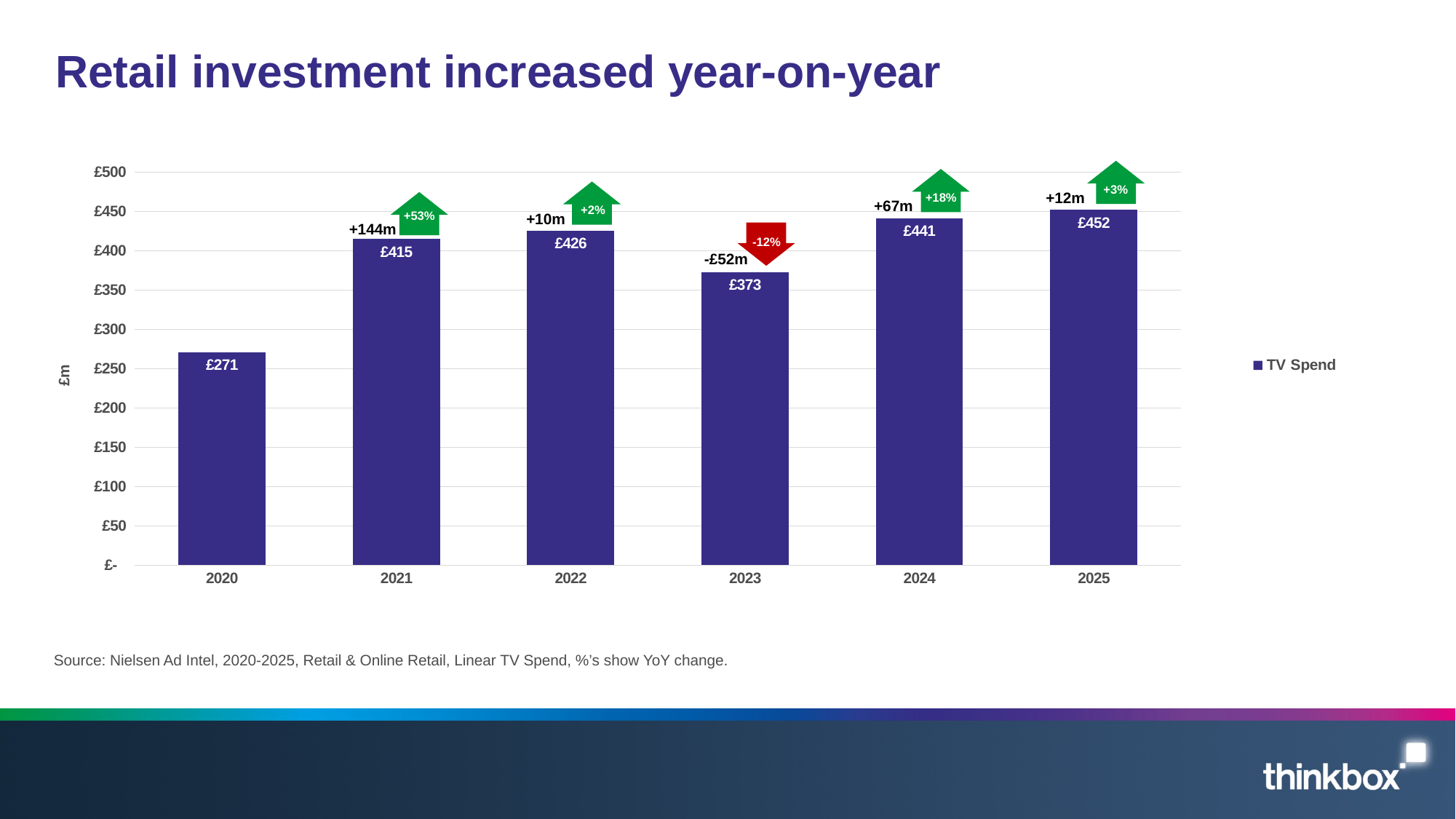
What is the TV Spend value for 2025? £452 How many series does the legend list? 1 How many years are shown on the x axis? 6 What year-on-year percentage change is shown above the 2021 bar? +53% What is the TV Spend value for 2020? £271 Which year has the highest TV Spend? 2025 Which year has a larger TV Spend, 2021 or 2022? 2022 Which year has the lowest TV Spend? 2020 Is the TV Spend value for 2020 greater or less than £300? less What kind of chart is shown on the slide? bar chart What is the TV Spend value for 2023? £373 What is the difference in TV Spend between 2024 and 2023? £68